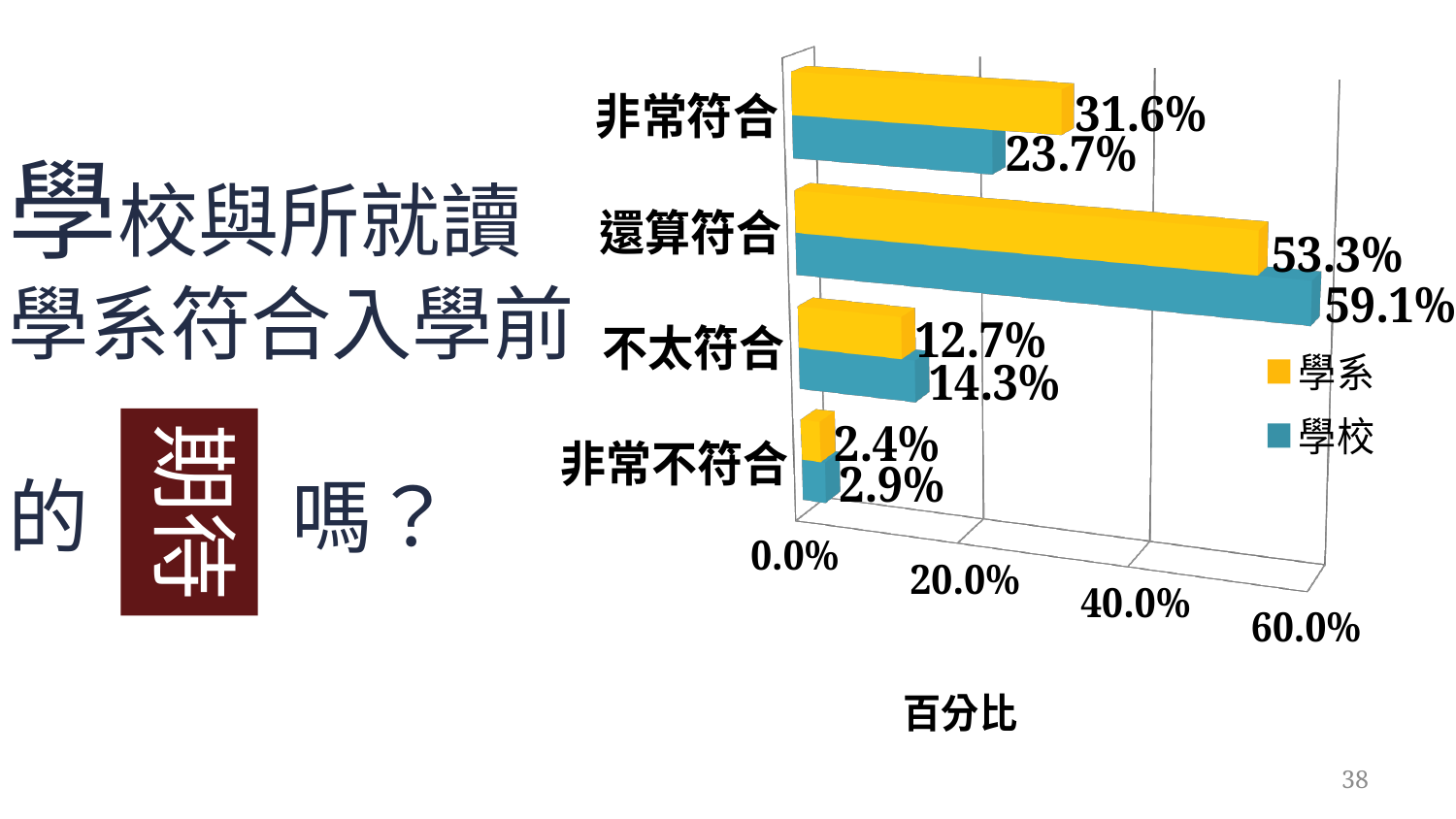
In the 還算符合 category, which series has the larger value, 學系 or 學校? 學校 What is the difference between 學系 and 學校 in the 非常符合 category? 7.9% What is the value for 學校 in the 非常不符合 category? 2.9% What kind of chart is shown on the slide? bar chart What is the value for 學校 in the 還算符合 category? 59.1% Which category has the highest value for 學校? 還算符合 How many categories are shown on the chart? 4 What is the value for 學系 in the 不太符合 category? 12.7% How many series does the legend list? 2 Which category has the lowest value for 學系? 非常不符合 What is the label of the horizontal axis? 百分比 What is the value for 學系 in the 非常符合 category? 31.6%